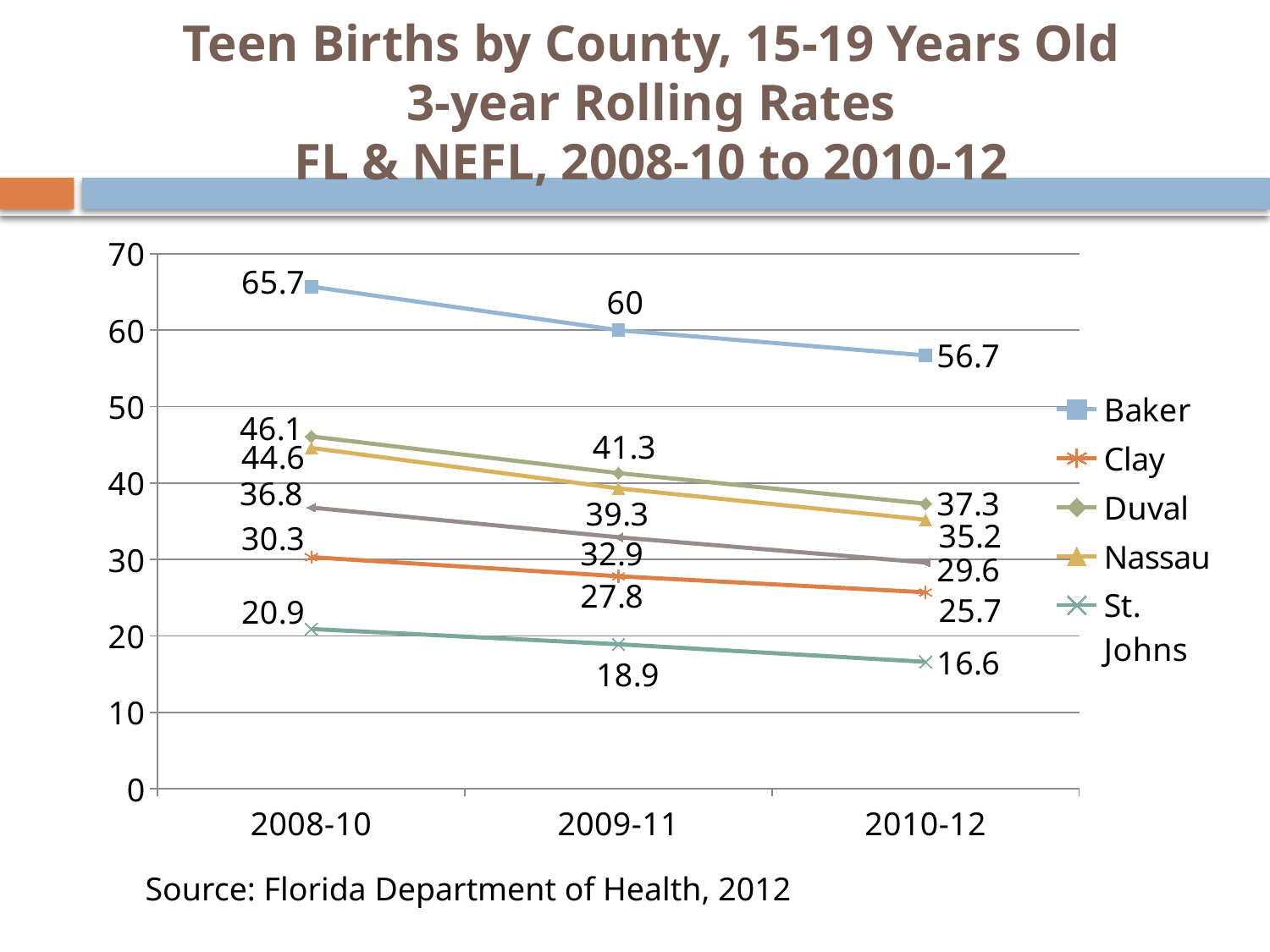
What is the teen birth rate for Clay in 2009-11? 27.8 Which is larger in 2009-11, the rate for Duval or the rate for Nassau? Duval What is the teen birth rate for Baker in 2008-10? 65.7 Does the teen birth rate for Clay rise or fall from 2008-10 to 2010-12? Fall Which county has the lowest teen birth rate in 2008-10? St. Johns Which county has the highest teen birth rate in 2010-12? Baker What is the teen birth rate for Duval in 2009-11? 41.3 What is the teen birth rate for Nassau in 2010-12? 35.2 What is the teen birth rate for St. Johns in 2010-12? 16.6 How many counties are listed in the legend? 5 By how much did Baker's teen birth rate fall from 2008-10 to 2010-12? 9 What type of chart is shown on the slide? Line chart